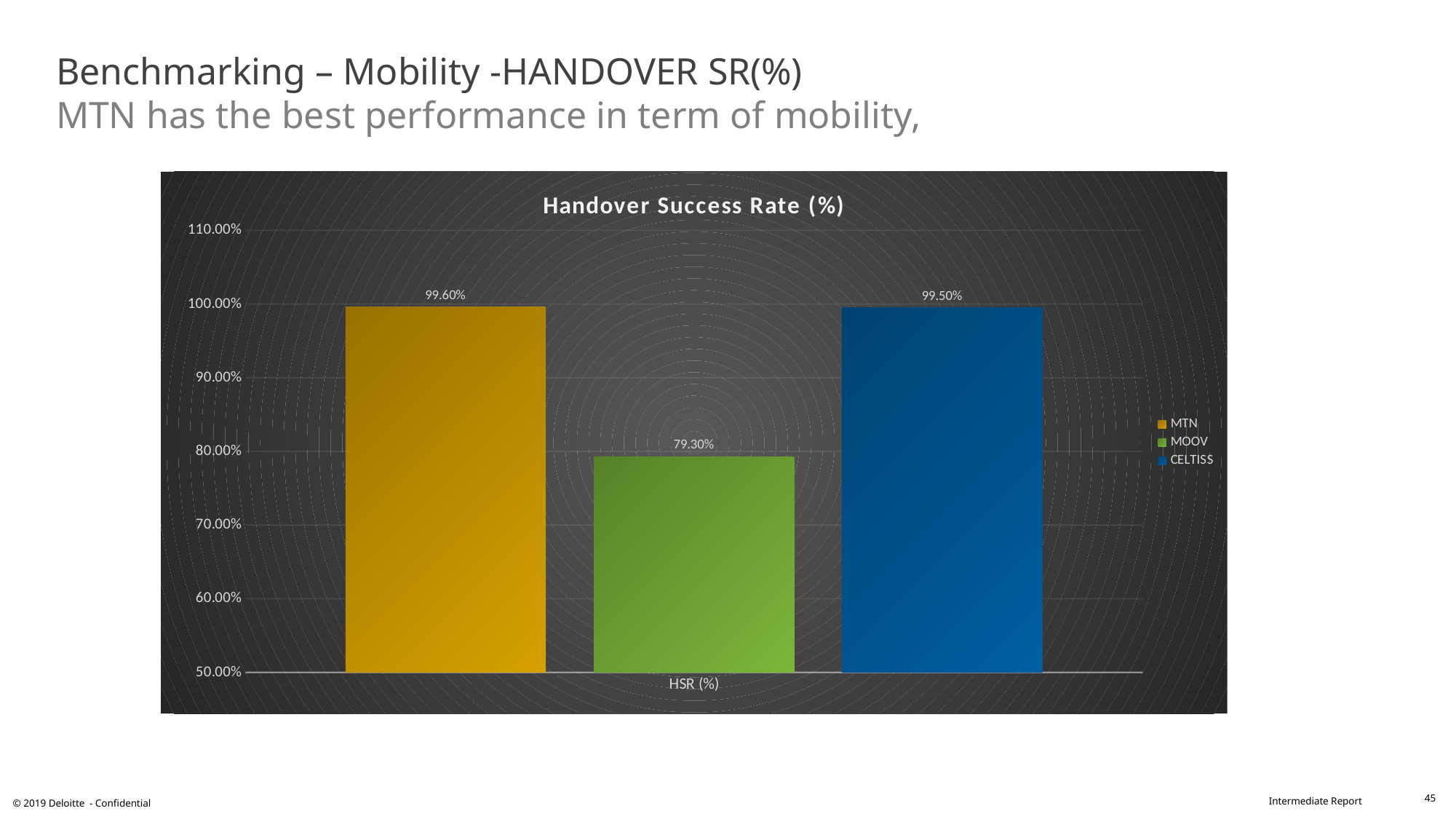
What is the Handover Success Rate for MTN? 99.60% What is the Handover Success Rate for MOOV? 79.30% What kind of chart is shown on the slide? Bar chart Is the value for MOOV greater or less than 80.00%? less What is the difference between the Handover Success Rate of MTN and MOOV? 20.30% Which is larger, the Handover Success Rate for MOOV or for CELTISS? CELTISS What is the Handover Success Rate for CELTISS? 99.50% What colour is the bar for CELTISS? Blue Which operator has the lowest Handover Success Rate? MOOV How many series does the legend list? 3 What is the difference between the Handover Success Rate of CELTISS and MOOV? 20.20% What is the title of the chart? Handover Success Rate (%)